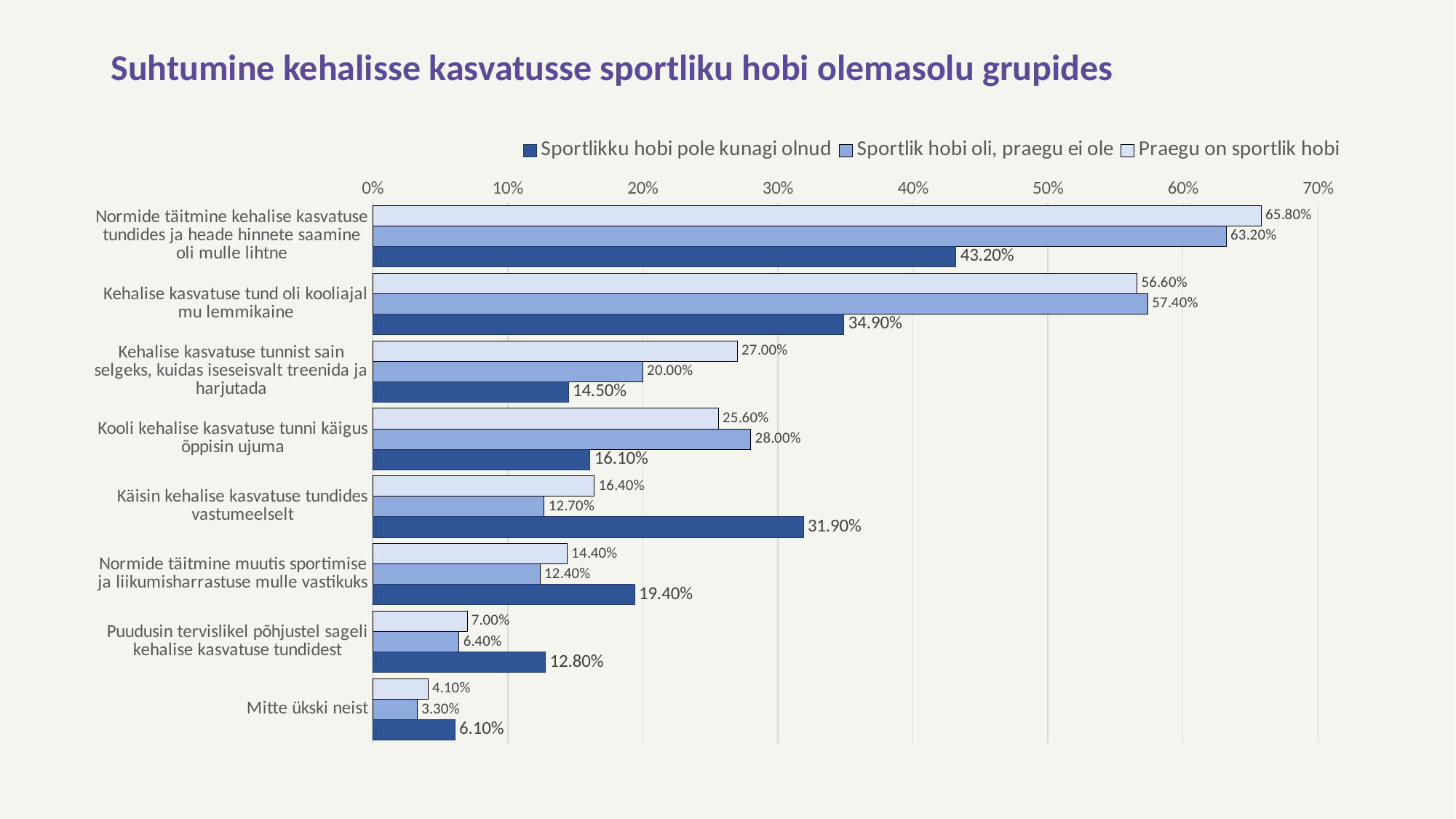
Is the value for 'Sportlikku hobi pole kunagi olnud' in the category 'Normide täitmine kehalise kasvatuse tundides ja heade hinnete saamine oli mulle lihtne' greater or less than 40%? greater What is the difference between 'Praegu on sportlik hobi' and 'Sportlikku hobi pole kunagi olnud' in the category 'Kehalise kasvatuse tund oli kooliajal mu lemmikaine'? 21.70% How many series does the legend list? 3 What is the value for 'Praegu on sportlik hobi' in the category 'Normide täitmine kehalise kasvatuse tundides ja heade hinnete saamine oli mulle lihtne'? 65.80% What is the value for 'Sportlikku hobi pole kunagi olnud' in the category 'Käisin kehalise kasvatuse tundides vastumeelselt'? 31.90% In the category 'Puudusin tervislikel põhjustel sageli kehalise kasvatuse tundidest', which series has the larger value: 'Sportlikku hobi pole kunagi olnud' or 'Praegu on sportlik hobi'? Sportlikku hobi pole kunagi olnud Which category has the lowest value for 'Sportlik hobi oli, praegu ei ole'? Mitte ükski neist How many categories are shown on the chart? 8 Which category has the highest value for 'Sportlikku hobi pole kunagi olnud'? Normide täitmine kehalise kasvatuse tundides ja heade hinnete saamine oli mulle lihtne What is the value for 'Sportlik hobi oli, praegu ei ole' in the category 'Kooli kehalise kasvatuse tunni käigus õppisin ujuma'? 28.00% What is the title of the chart? Suhtumine kehalisse kasvatusse sportliku hobi olemasolu grupides What type of chart is shown on the slide? Bar chart